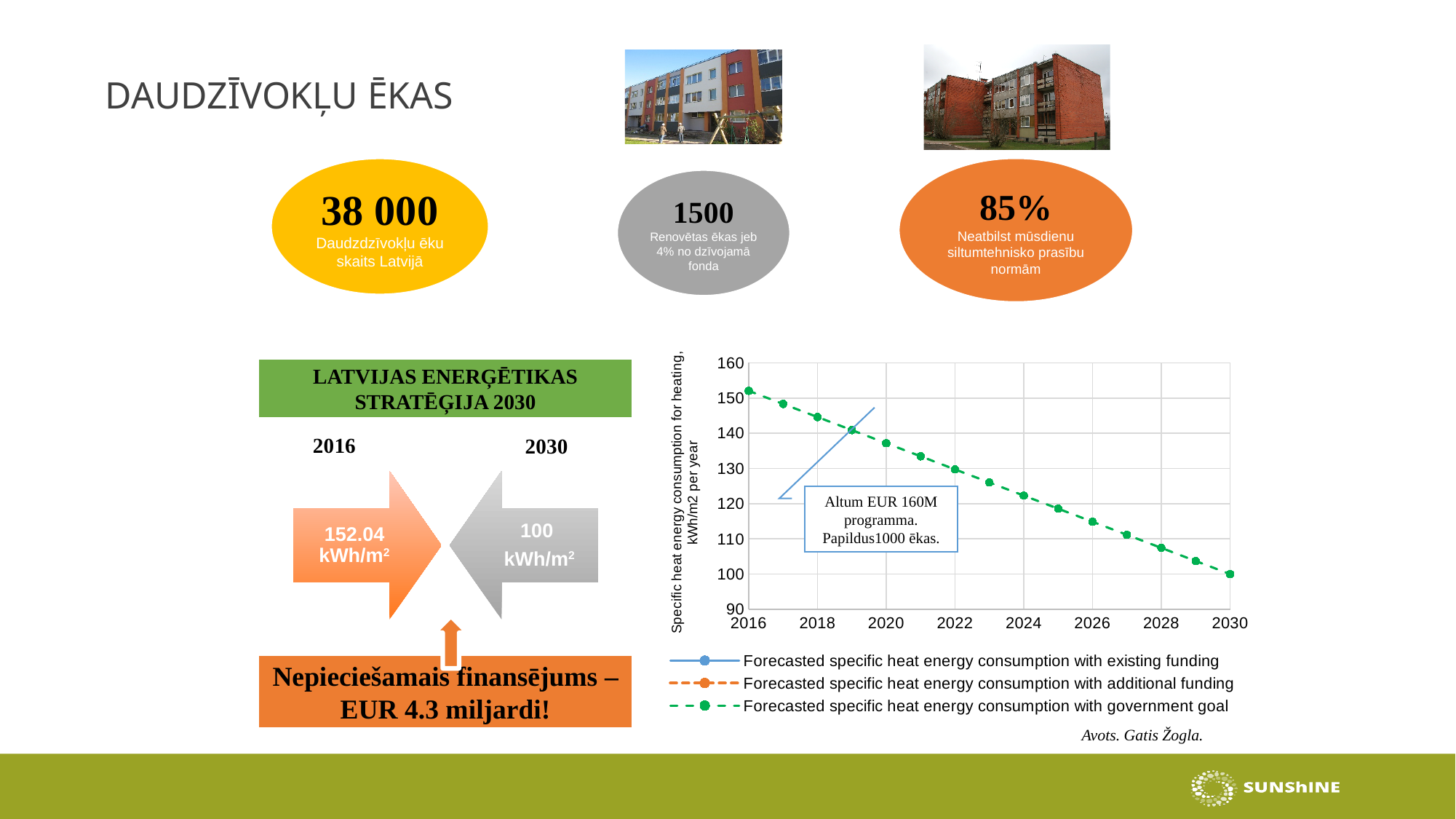
In the line chart, what is the value of the government goal series in 2030? 100 What kind of chart is shown on the right side of the slide? line chart In the line chart, which year has the lowest value? 2030 In the line chart, is the value for 2028 greater or less than 110? less In the line chart, is the value for 2024 greater or less than 120? greater In the line chart, do the values rise or fall from 2016 to 2030? fall How many series does the legend of the line chart list? 3 What colour is the line for the series 'Forecasted specific heat energy consumption with government goal'? green In the line chart, is the value for 2016 greater or less than 150? greater In the line chart, which year has the highest value, 2016 or 2030? 2016 What is the y-axis label of the line chart? Specific heat energy consumption for heating, kWh/m2 per year